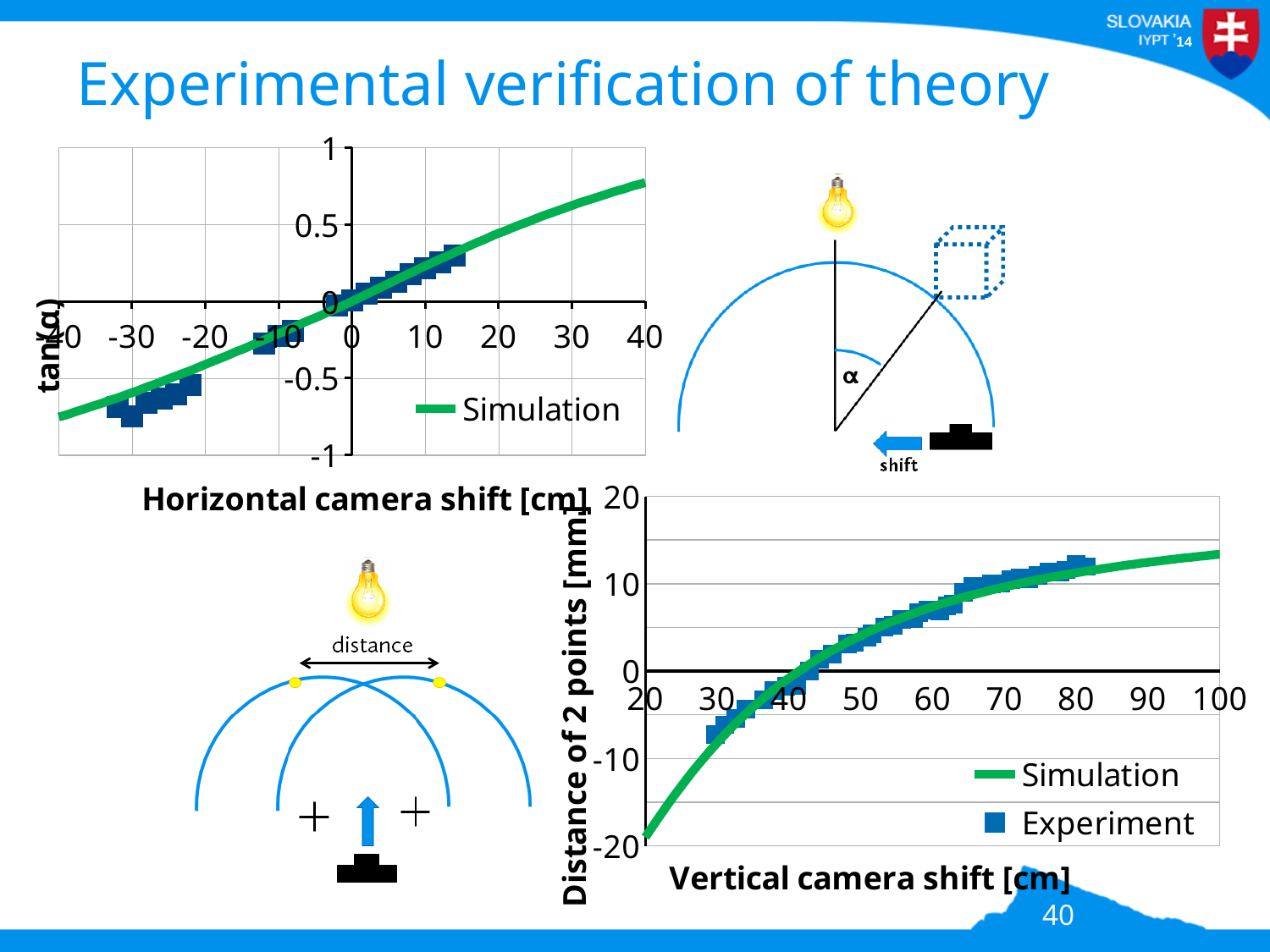
In the chart titled 'Horizontal camera shift [cm]', does the Simulation line rise or fall as the horizontal camera shift increases from -40 to 40? rise In the chart titled 'Vertical camera shift [cm]', is the Experiment value at a vertical camera shift of 80 cm greater or less than 10? greater What is the y-axis label of the chart titled 'Horizontal camera shift [cm]'? tan(α) What kind of chart is the chart titled 'Horizontal camera shift [cm]'? line chart with scatter points In the chart titled 'Vertical camera shift [cm]', is the Simulation value at a vertical camera shift of 100 cm greater or less than 10? greater How many series does the legend of the chart titled 'Vertical camera shift [cm]' list? 2 In the chart titled 'Horizontal camera shift [cm]', is the Simulation value at a horizontal camera shift of -30 cm greater or less than -0.5? less What is the y-axis label of the chart titled 'Vertical camera shift [cm]'? Distance of 2 points [mm] How many series does the legend of the chart titled 'Horizontal camera shift [cm]' list? 1 In the chart titled 'Vertical camera shift [cm]', does the Simulation line rise or fall as the vertical camera shift increases from 20 to 100? rise